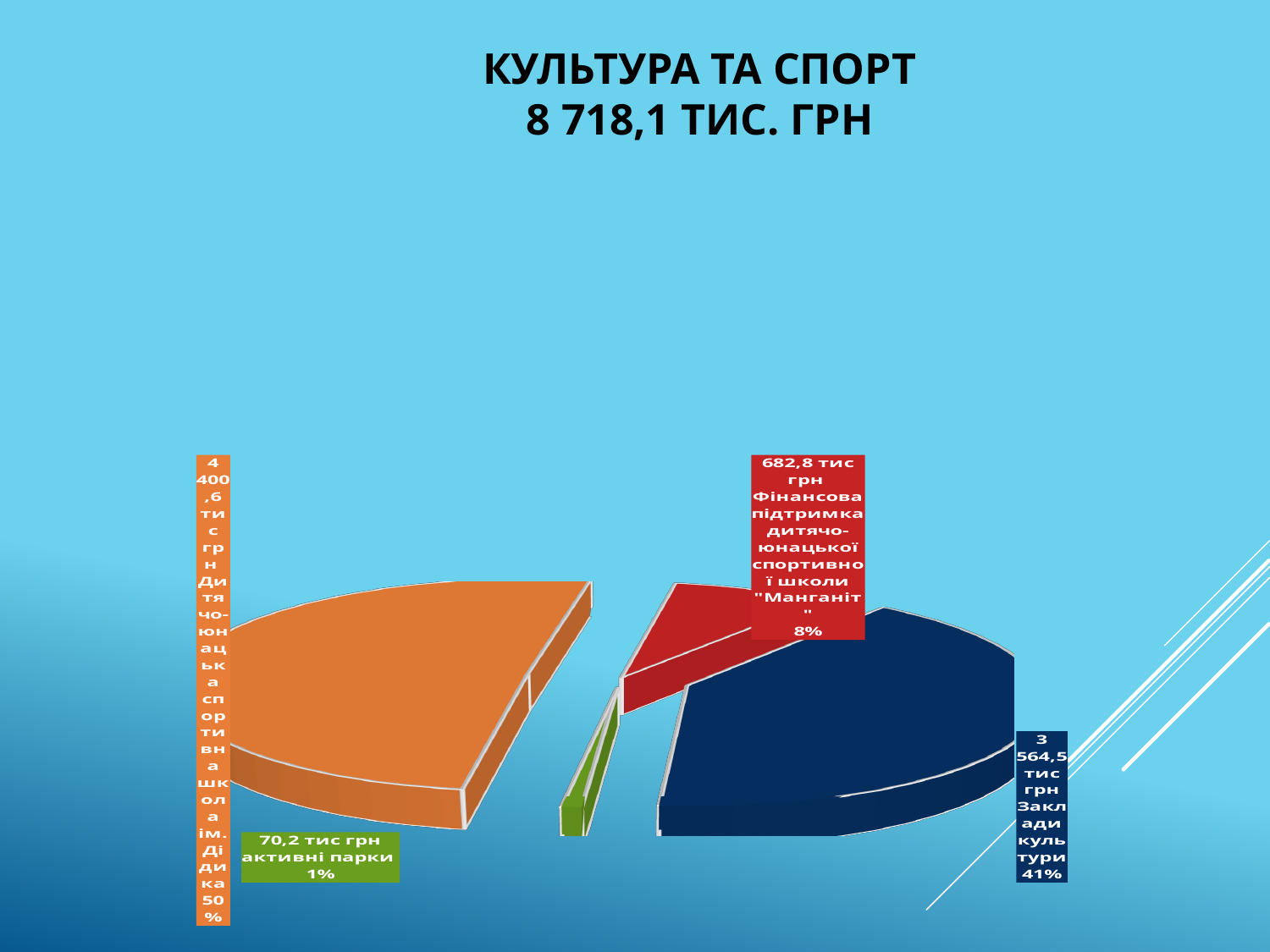
How many slices does the pie chart have? 4 What share of the pie does "Фінансова підтримка дитячо-юнацької спортивної школи "Манганіт"" represent? 8% What is the title of the chart on the slide? КУЛЬТУРА ТА СПОРТ 8 718,1 ТИС. ГРН What share of the pie does "Заклади культури" represent? 41% What share of the pie does "активні парки" represent? 1% What is the value shown for "активні парки"? 70,2 тис грн What is the value shown for "Заклади культури"? 3 564,5 тис грн Which category has the smallest slice of the pie? активні парки Which is larger: the value for "Заклади культури" or the value for "активні парки"? Заклади культури What is the value shown for "Фінансова підтримка дитячо-юнацької спортивної школи "Манганіт""? 682,8 тис грн What kind of chart is shown on the slide? Pie chart Which category has the largest slice of the pie? Дитячо-юнацька спортивна школа ім. Дідика